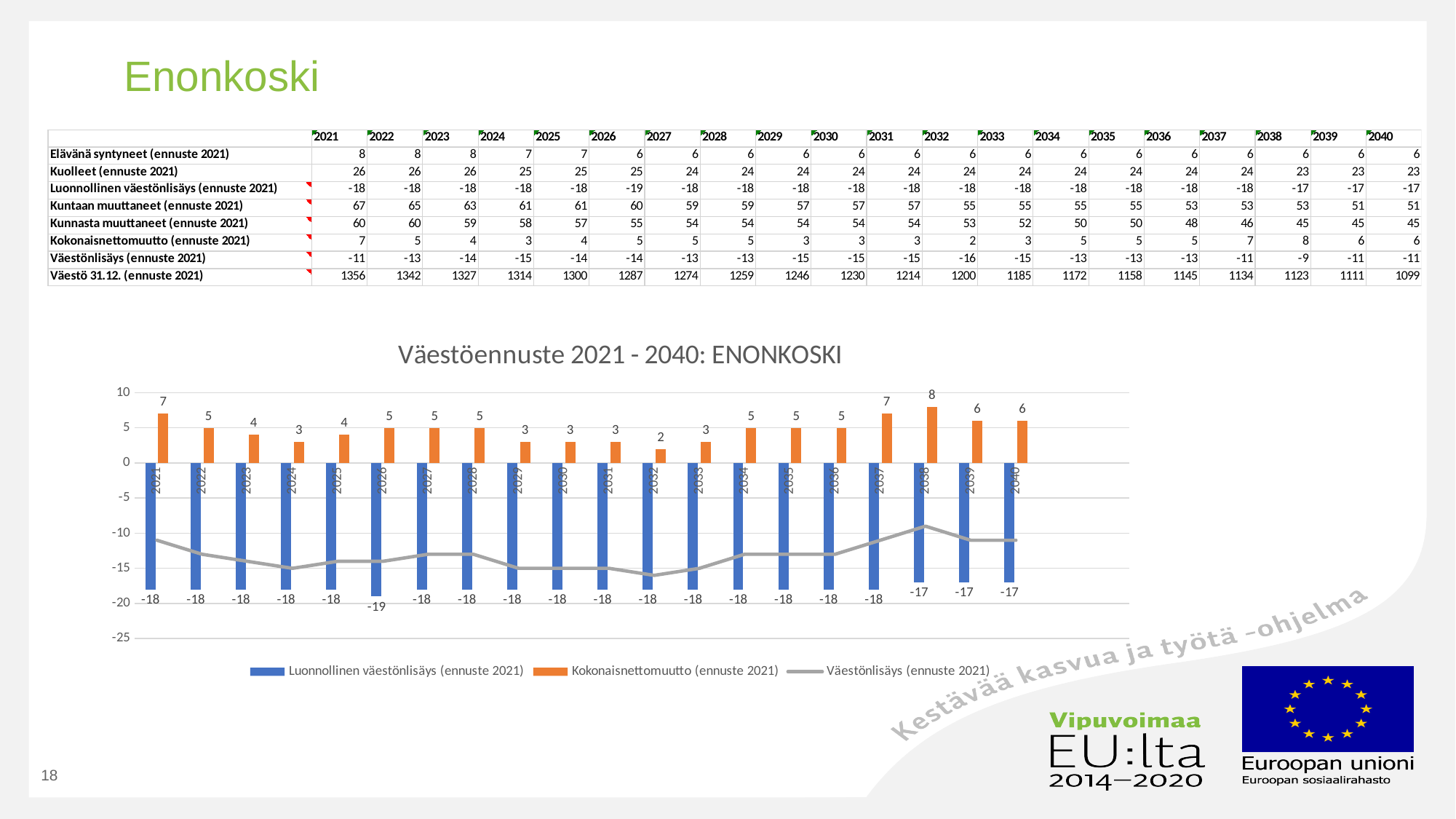
What kind of chart is shown under the title 'Väestöennuste 2021 - 2040: ENONKOSKI'? bar chart with a line What is the value of Luonnollinen väestönlisäys (ennuste 2021) for 2026 in the chart? -19 In which year is Kokonaisnettomuutto (ennuste 2021) lowest in the chart? 2032 In which year is Kokonaisnettomuutto (ennuste 2021) highest in the chart? 2038 What is the value of Luonnollinen väestönlisäys (ennuste 2021) for 2040 in the chart? -17 How many years are plotted along the x axis of the chart? 20 Is the Väestönlisäys (ennuste 2021) line value for 2038 greater or less than -5? less Which year has the larger Kokonaisnettomuutto value in the chart, 2021 or 2022? 2021 What is the difference between the Kokonaisnettomuutto values for 2038 and 2032 in the chart? 6 What is the value of Kokonaisnettomuutto (ennuste 2021) for 2021 in the chart? 7 Between 2032 and 2038, does the Kokonaisnettomuutto series rise or fall in the chart? rise How many series does the legend of the chart list? 3